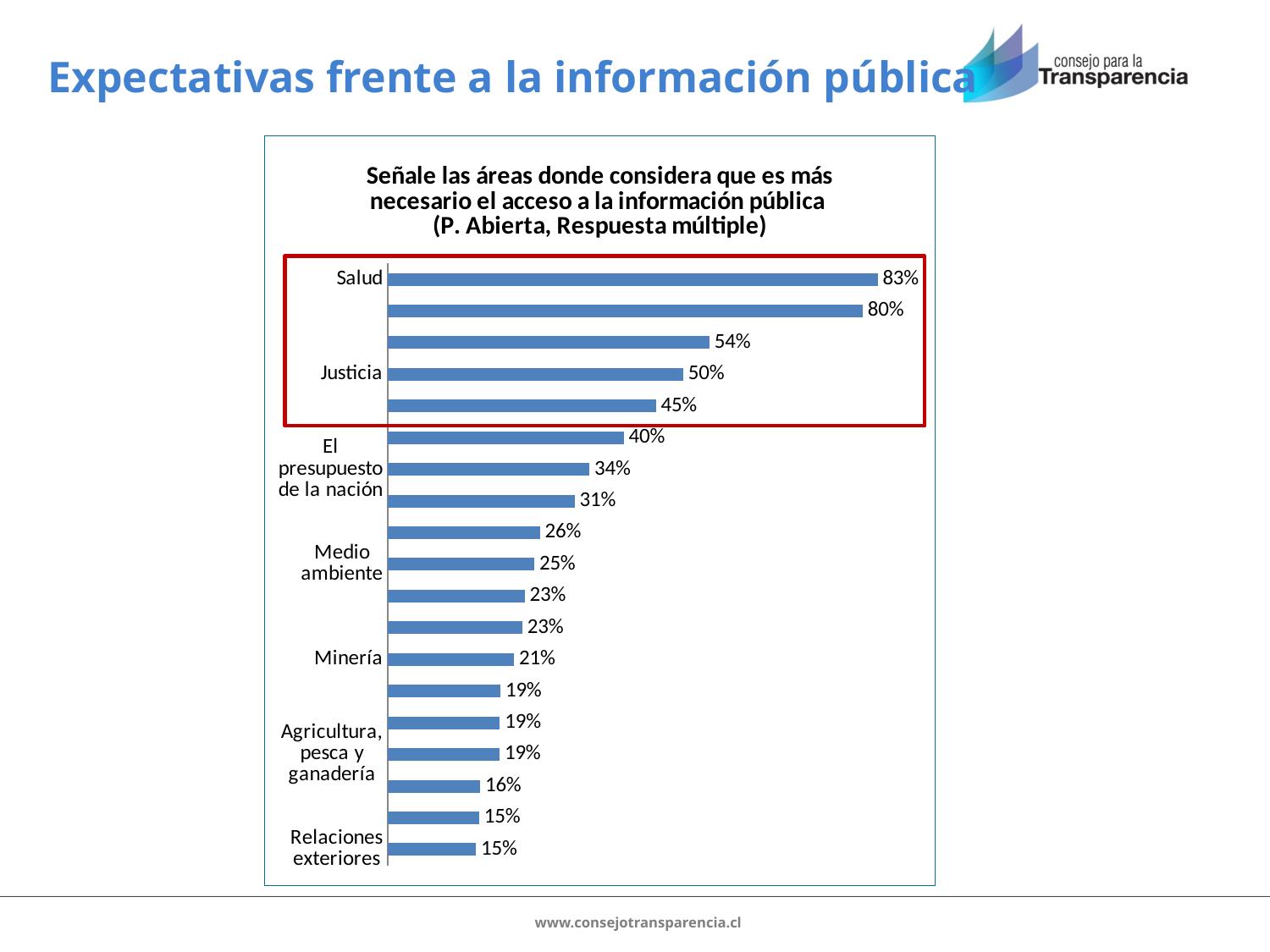
What percentage is shown for El presupuesto de la nación? 34% What percentage is shown for Minería? 21% What is the difference in percentage points between Salud and Justicia? 33 percentage points What percentage is shown for Relaciones exteriores? 15% Which has a larger value, Medio ambiente or Minería? Medio ambiente What percentage is shown for Justicia? 50% What percentage is shown for Medio ambiente? 25% What percentage is shown for Salud? 83% Which labelled area has the highest percentage? Salud How many bars are plotted on the chart? 19 What kind of chart is shown on the slide? Bar chart What is the highest value shown on the chart? 83%